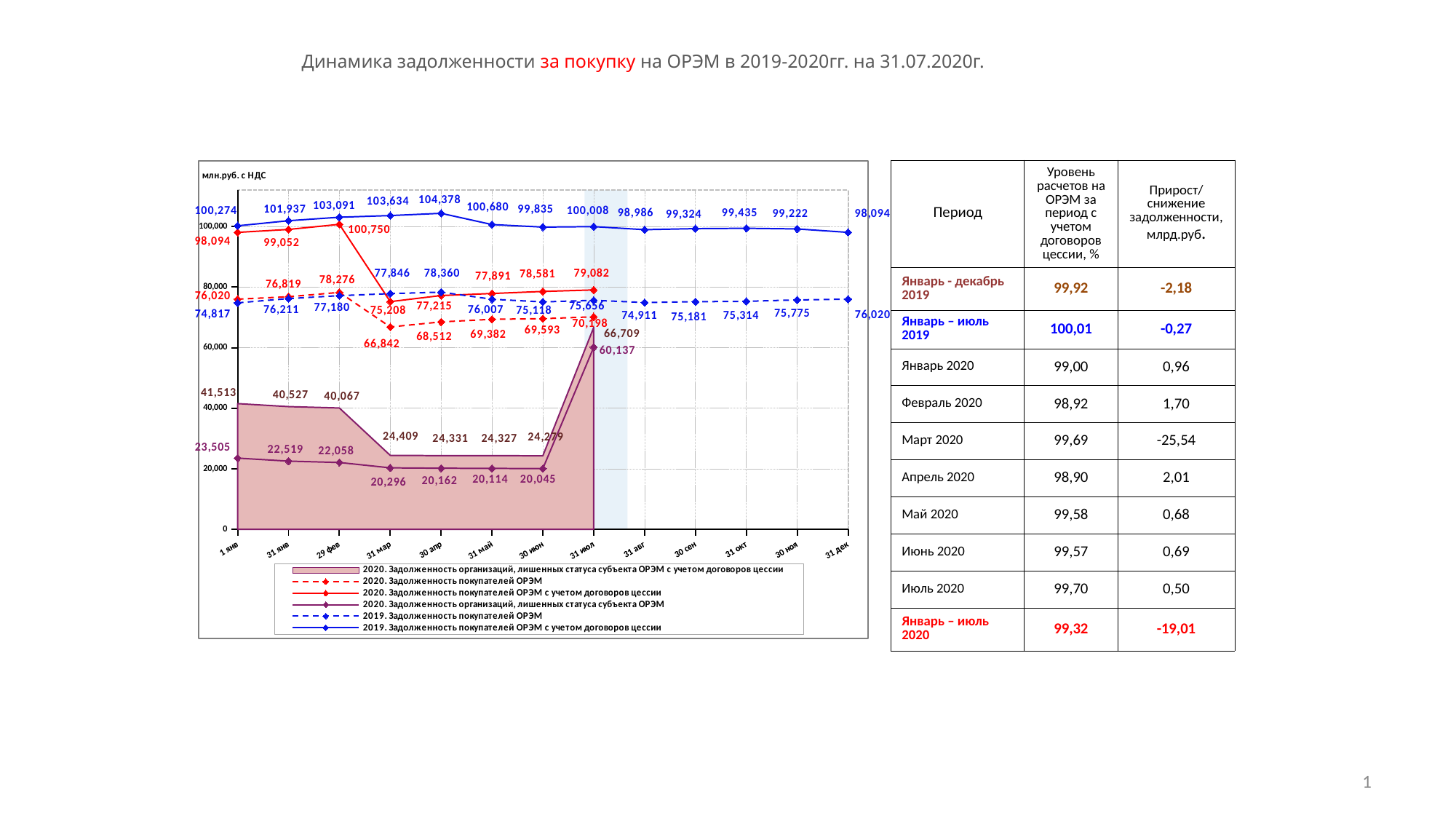
What is the value of the series '2020. Задолженность покупателей ОРЭМ с учетом договоров цессии' at 31 июл? 79,082 How many dates are marked along the x axis of the chart? 13 What unit is shown in the top-left corner of the chart's y axis? млн.руб. с НДС Is the value of '2020. Задолженность организаций, лишенных статуса субъекта ОРЭМ' at 31 июл greater or less than 40,000? greater What kind of chart is shown on the slide? combination area and line chart At which date does the series '2019. Задолженность покупателей ОРЭМ с учетом договоров цессии' reach its highest value? 30 апр What is the value of the series '2019. Задолженность покупателей ОРЭМ' at 31 дек? 76,020 At which date is the series '2020. Задолженность организаций, лишенных статуса субъекта ОРЭМ' at its lowest value? 30 июн How many series does the chart legend list? 6 By how much did the series '2020. Задолженность покупателей ОРЭМ с учетом договоров цессии' fall between 29 фев and 31 мар? 25,542 What is the value of the series '2019. Задолженность покупателей ОРЭМ с учетом договоров цессии' at 30 апр? 104,378 At 31 июл, which is larger: '2020. Задолженность организаций, лишенных статуса субъекта ОРЭМ с учетом договоров цессии' or '2020. Задолженность организаций, лишенных статуса субъекта ОРЭМ'? 2020. Задолженность организаций, лишенных статуса субъекта ОРЭМ с учетом договоров цессии